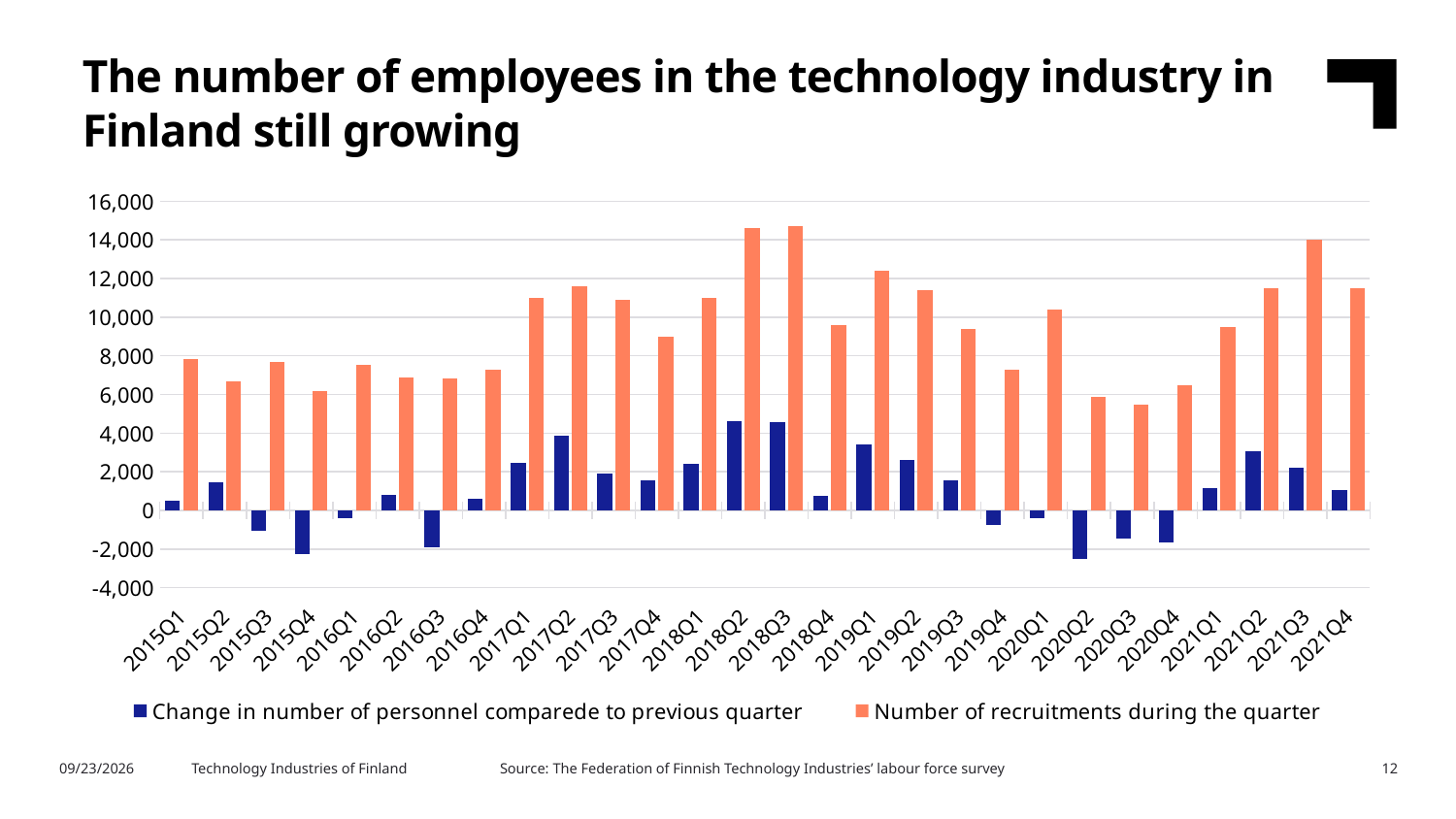
Is the change in number of personnel compared to previous quarter for 2017Q2 greater or less than 2,000? greater Is the number of recruitments during the quarter for 2021Q3 greater or less than 12,000? greater How many quarters are shown on the x axis? 28 Do the number of recruitments during the quarter rise or fall from 2020Q3 to 2021Q3? rise Which quarter has the larger number of recruitments during the quarter, 2020Q1 or 2020Q2? 2020Q1 Which quarter has the larger number of recruitments during the quarter, 2021Q3 or 2021Q4? 2021Q3 What colour are the bars for the number of recruitments during the quarter? Orange What kind of chart is shown on the slide? Bar chart Is the number of recruitments during the quarter for 2020Q3 greater or less than 6,000? less How many series does the legend list? 2